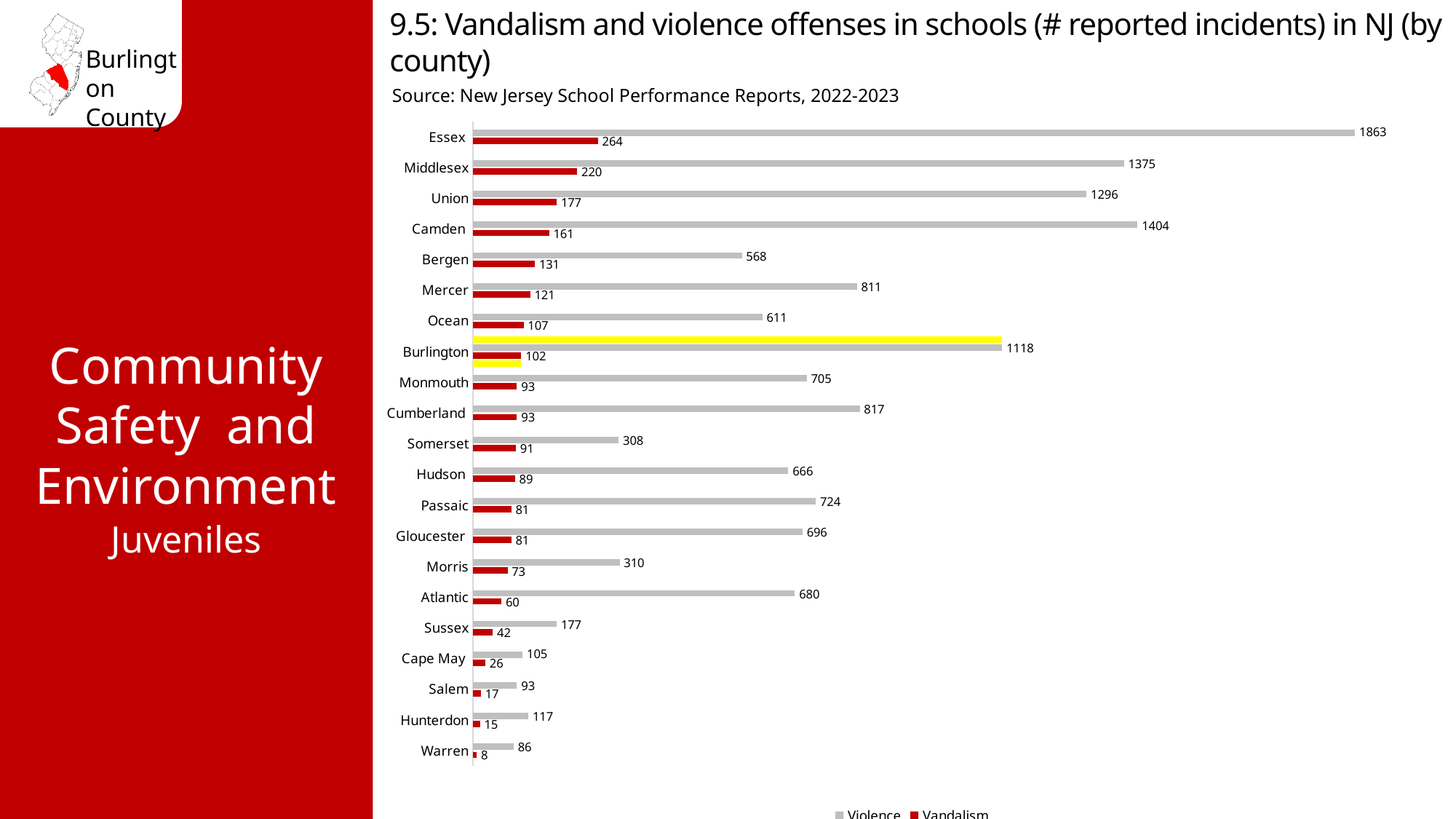
Which county has the highest number of reported violence incidents? Essex What is the number of reported vandalism incidents in Burlington County? 102 Which county has a higher vandalism value, Union or Camden? Union What is the violence value for Camden? 1404 What is the number of reported violence incidents in Burlington County? 1118 What is the difference between the vandalism values for Burlington and Monmouth? 9 Which county has a higher violence value, Cumberland or Mercer? Cumberland Which county has the lowest number of reported vandalism incidents? Warren What type of chart is shown on the slide? Bar chart What is the difference between the violence values for Essex and Middlesex? 488 How many counties are shown in the chart? 21 How many series does the legend list? 2